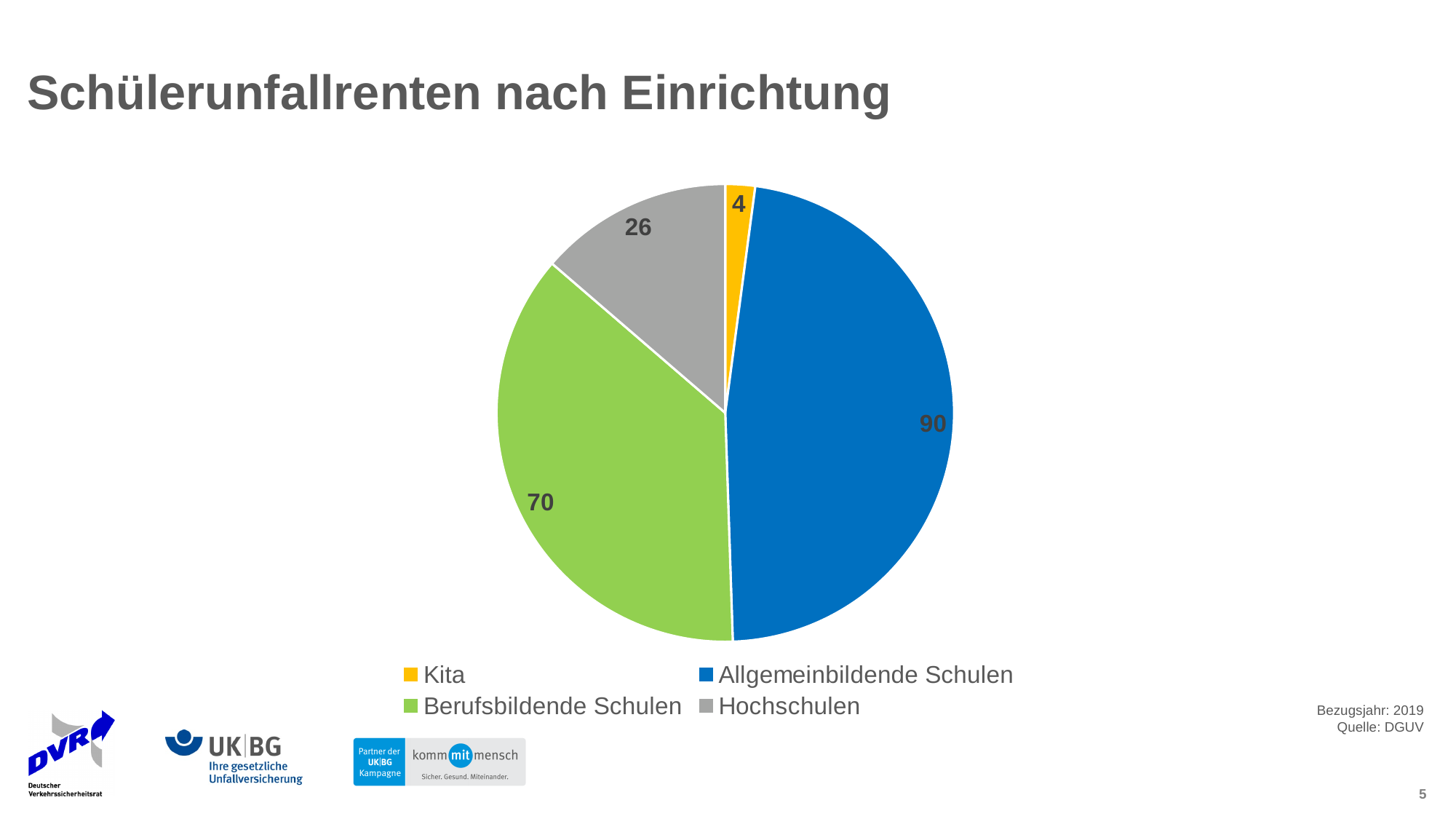
What is the difference between the values for Allgemeinbildende Schulen and Berufsbildende Schulen? 20 Which category has the highest value? Allgemeinbildende Schulen Which is larger, the value for Hochschulen or the value for Kita? Hochschulen What is the value for Allgemeinbildende Schulen? 90 What is the total of all slices in the pie chart? 190 What is the value for Berufsbildende Schulen? 70 What is the value for Kita? 4 What is the title of the chart? Schülerunfallrenten nach Einrichtung How many categories does the pie chart have? 4 What is the value for Hochschulen? 26 What type of chart is shown on the slide? pie chart Which category has the lowest value? Kita